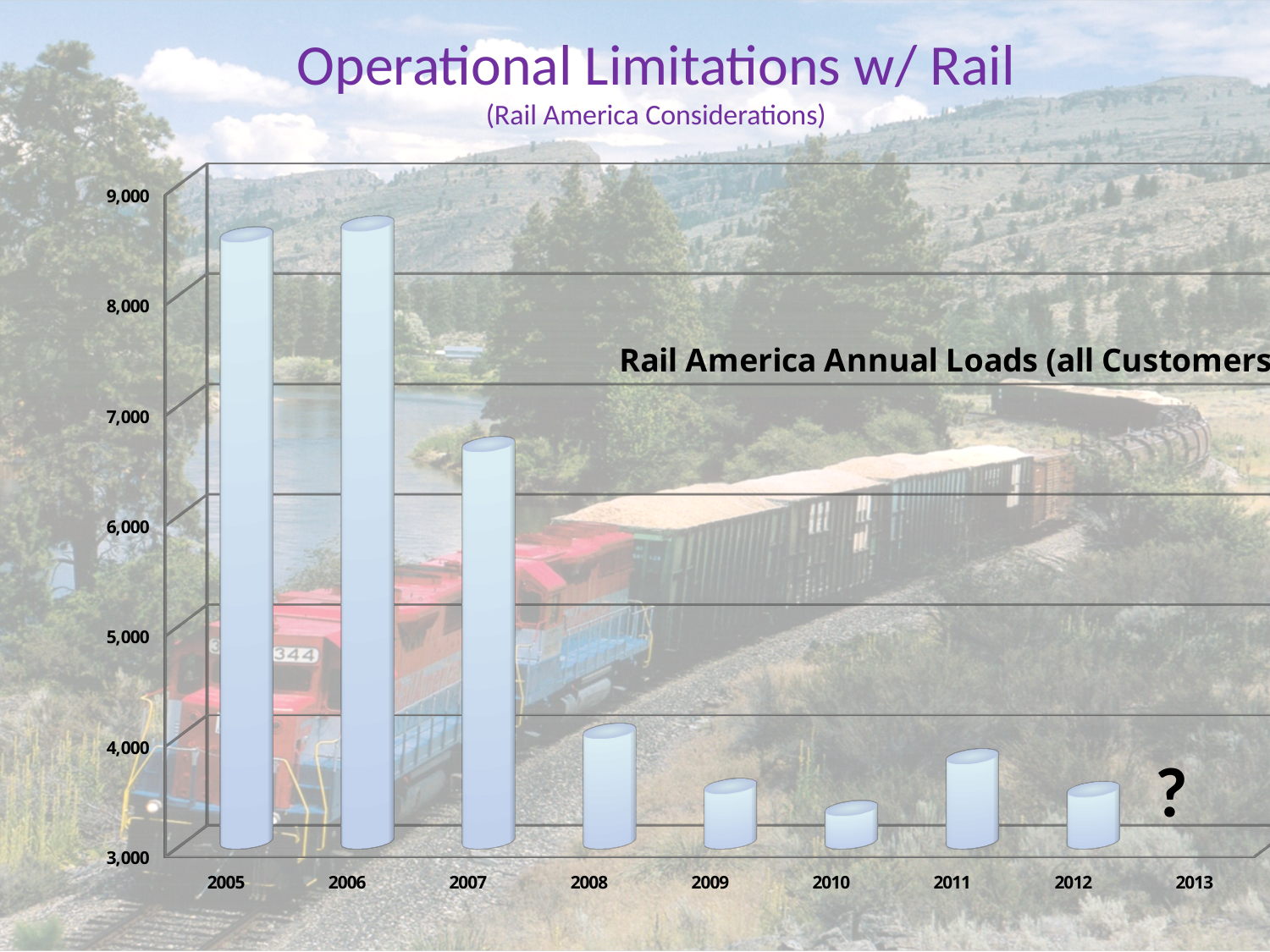
Is the value for 2008 greater or less than 5,000? less Do the values generally rise or fall from 2005 to 2010? fall Is the value for 2009 greater or less than 4,000? less Is the value for 2007 greater or less than 6,000? greater Which year has the larger value, 2007 or 2008? 2007 What is the title of the chart? Rail America Annual Loads (all Customers) Which year has the larger value, 2010 or 2011? 2011 How many years are labelled on the x axis of the chart? 9 Which year has the lowest bar in the chart? 2010 What kind of chart is shown on the slide? bar chart